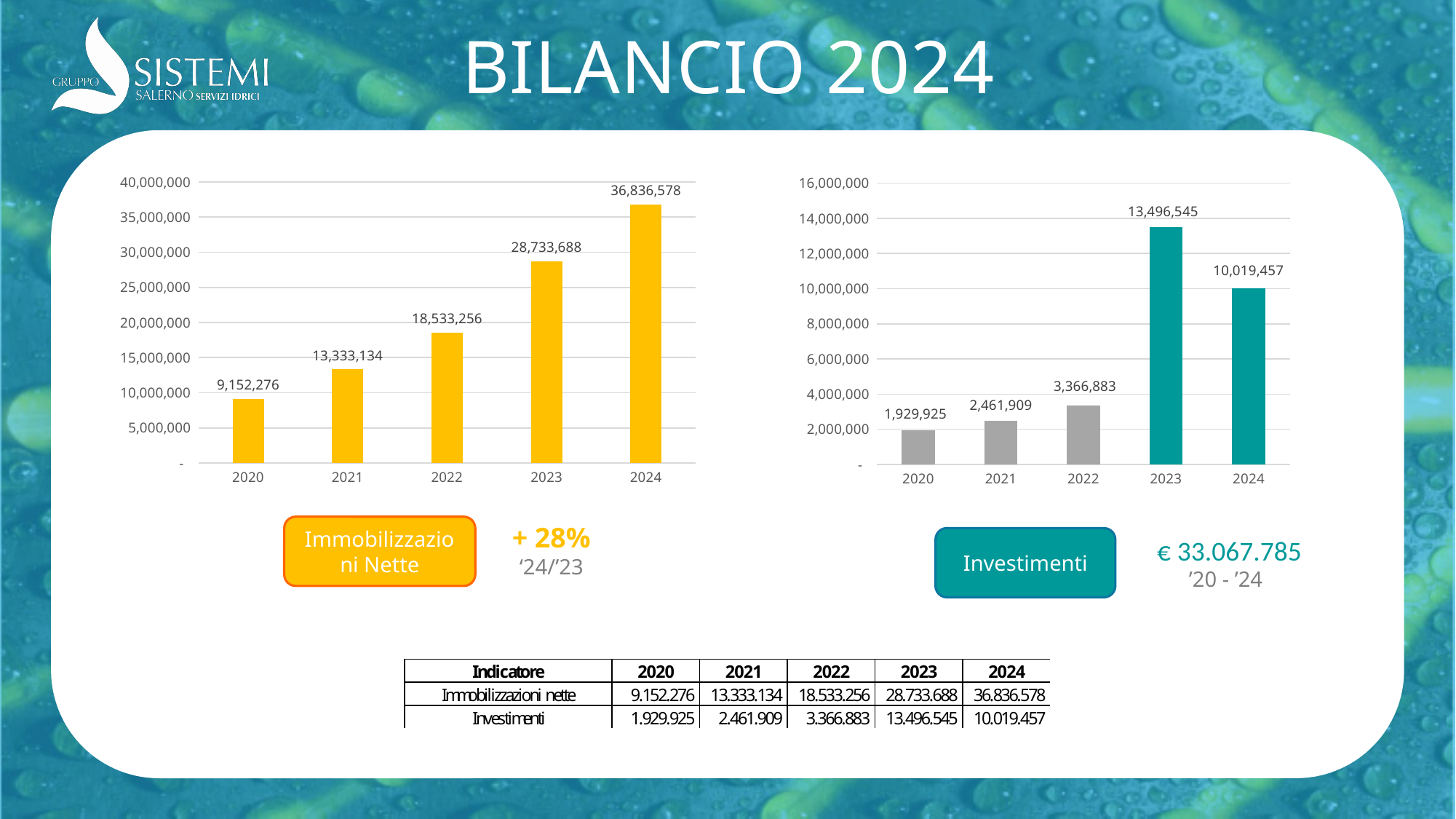
How many years are shown on the x axis of the left chart (Immobilizzazioni Nette)? 5 What kind of chart is the right chart (Investimenti)? bar chart In the right chart (Investimenti), which year has the highest value? 2023 In the left chart (Immobilizzazioni Nette), what is the value for 2022? 18,533,256 In the right chart (Investimenti), what is the difference between the 2023 and 2024 values? 3,477,088 In the left chart (Immobilizzazioni Nette), which year has the highest value? 2024 In the left chart (Immobilizzazioni Nette), do the values rise or fall from 2020 to 2024? rise In the right chart (Investimenti), which is larger, the value for 2022 or the value for 2024? 2024 In the right chart (Investimenti), which year has the lowest value? 2020 In the left chart (Immobilizzazioni Nette), what is the difference between the 2024 and 2023 values? 8,102,890 In the left chart (Immobilizzazioni Nette), is the value for 2021 greater or less than 15,000,000? less In the right chart (Investimenti), what is the value for 2021? 2,461,909